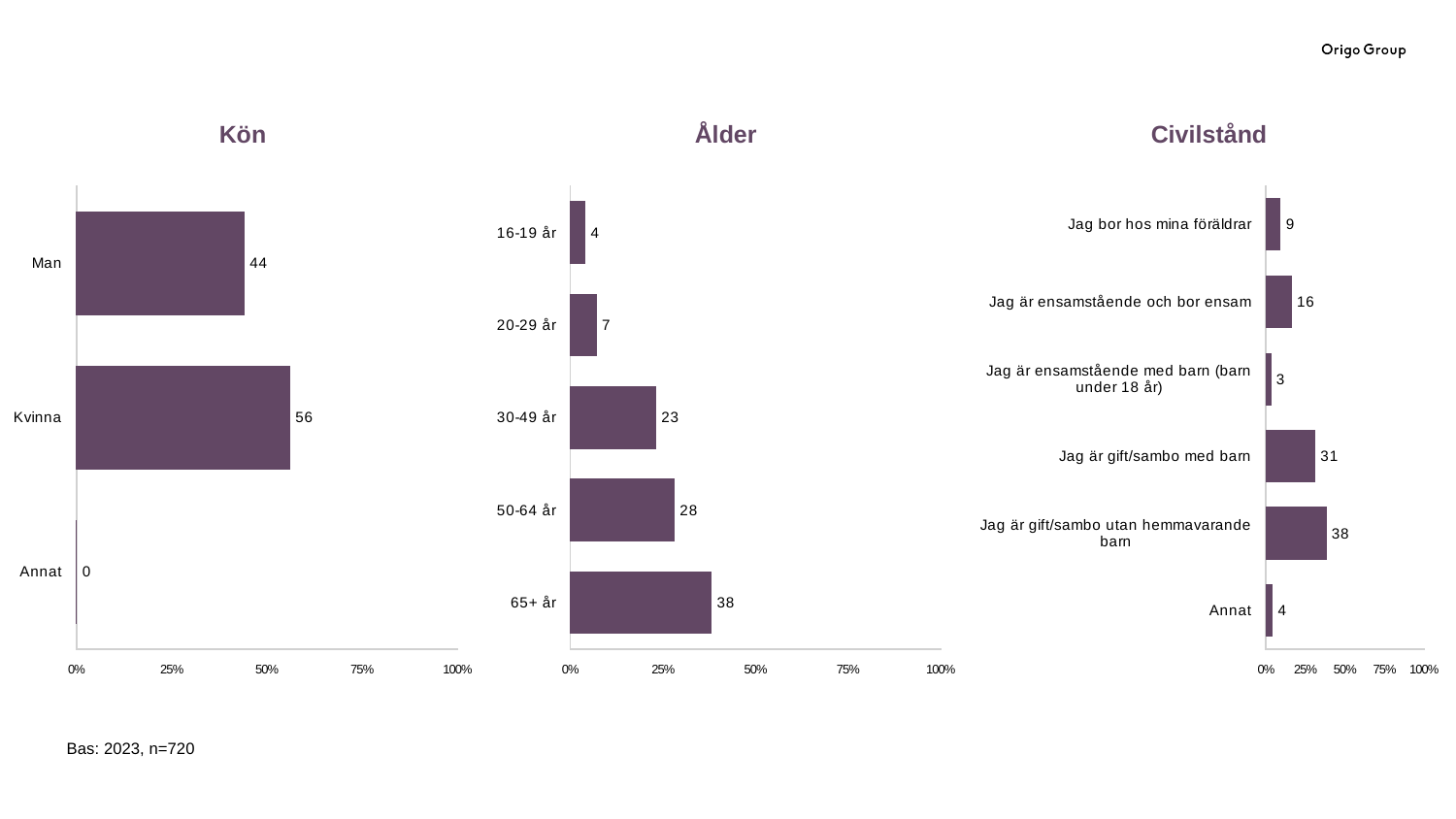
In the Ålder chart, do the values rise or fall from 16-19 år to 65+ år? rise In the Civilstånd chart, is the value for Jag är gift/sambo utan hemmavarande barn greater or less than 25%? greater What kind of chart is the Kön chart? bar chart In the Ålder chart, what is the value for 30-49 år? 23 In the Civilstånd chart, which category has the highest value? Jag är gift/sambo utan hemmavarande barn In the Civilstånd chart, what is the value for Jag är gift/sambo med barn? 31 In the Ålder chart, how many age groups are shown? 5 In the Civilstånd chart, which is larger: Jag är ensamstående och bor ensam or Jag bor hos mina föräldrar? Jag är ensamstående och bor ensam In the Kön chart, what is the difference between the values for Kvinna and Man? 12 In the Ålder chart, which age group has the lowest value? 16-19 år In the Kön chart, what is the value for Kvinna? 56 In the Kön chart, which category has the highest value? Kvinna